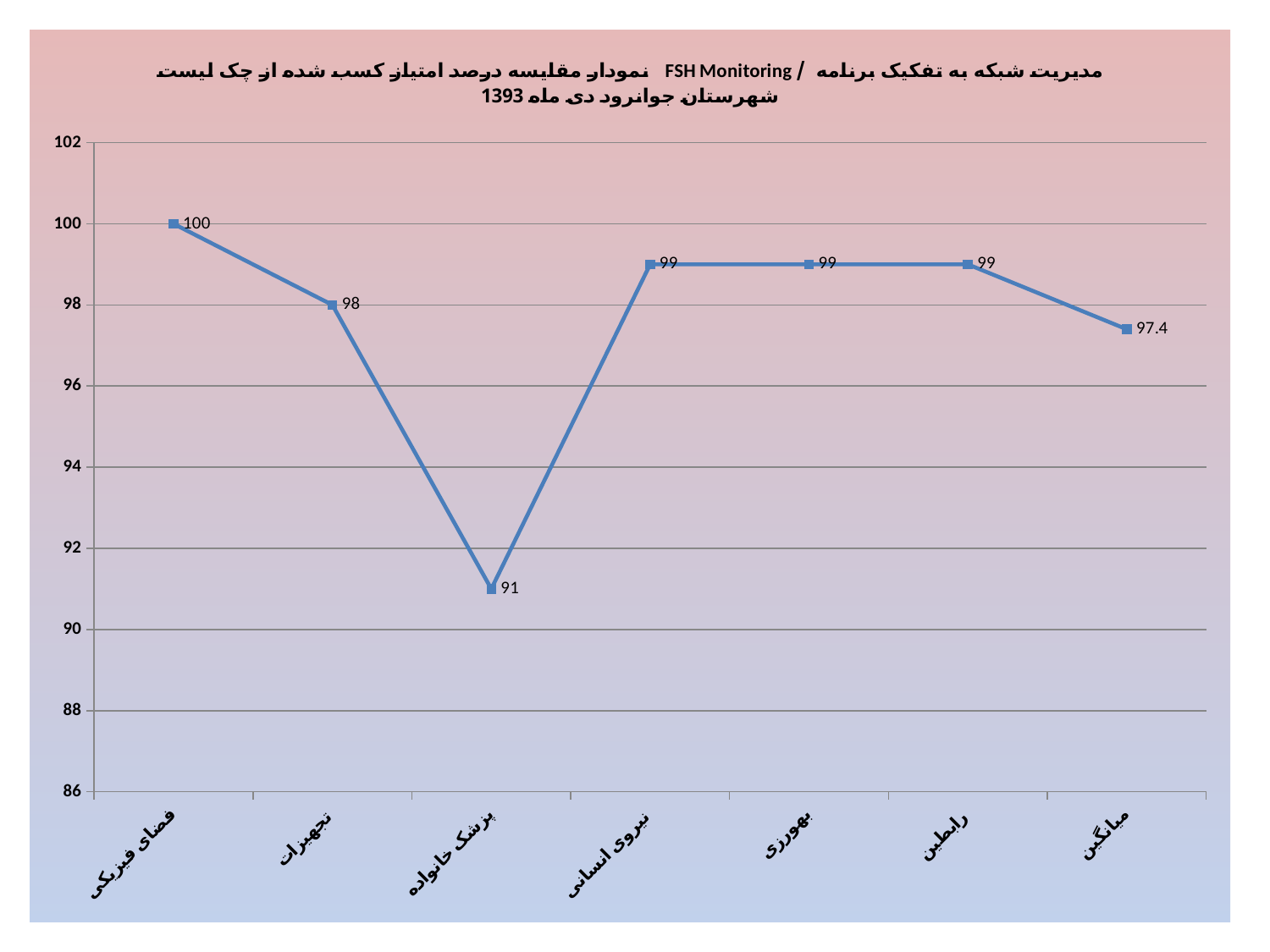
Which category has the highest value? فضای فیزیکی What is the value for تجهیزات? 98 What is the value for پزشک خانواده? 91 Is the value for پزشک خانواده greater or less than 92? less What is the difference between the values for فضای فیزیکی and پزشک خانواده? 9 Which is larger, the value for تجهیزات or the value for بهورزی? بهورزی Which category has the lowest value? پزشک خانواده What kind of chart is shown on the slide? line chart How many categories are plotted on the x axis? 7 What is the value for فضای فیزیکی? 100 Do the values rise or fall from فضای فیزیکی to پزشک خانواده? fall What is the value for میانگین? 97.4